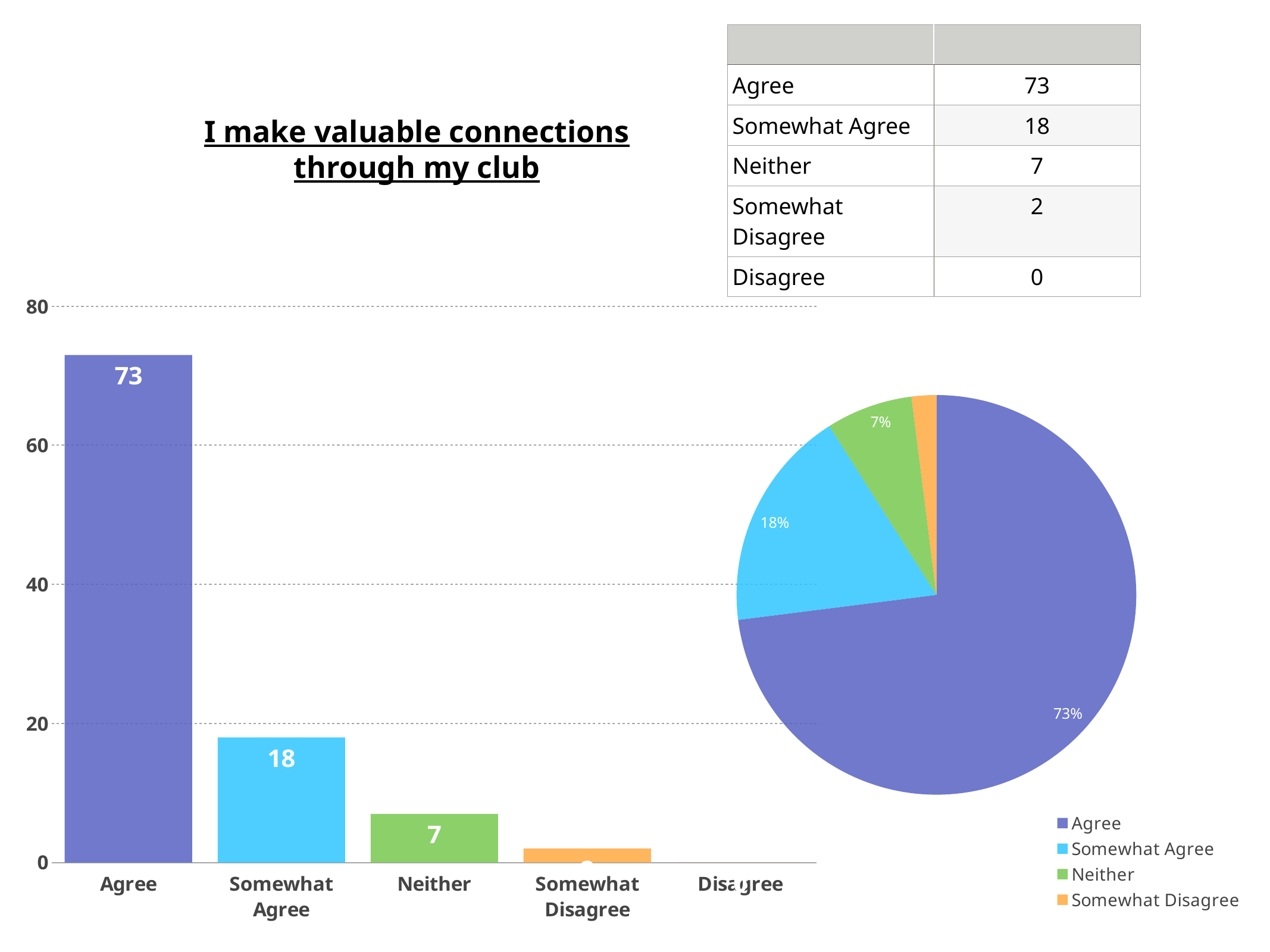
How many entries does the legend of the pie chart list? 4 In the bar chart, which category has the highest value? Agree In the bar chart, what is the value for Agree? 73 In the bar chart, which is larger, the value for Neither or the value for Somewhat Disagree? Neither In the pie chart, what share does the Somewhat Agree slice have? 18% In the bar chart, what is the value for Neither? 7 In the bar chart, is the value for Somewhat Agree greater or less than 20? less In the bar chart, what is the difference between the values for Agree and Somewhat Agree? 55 In the bar chart, what is the value for Somewhat Agree? 18 How many categories are shown on the x axis of the bar chart? 5 What kind of chart is the chart on the left of the slide? bar chart In the pie chart, what share does the Agree slice have? 73%